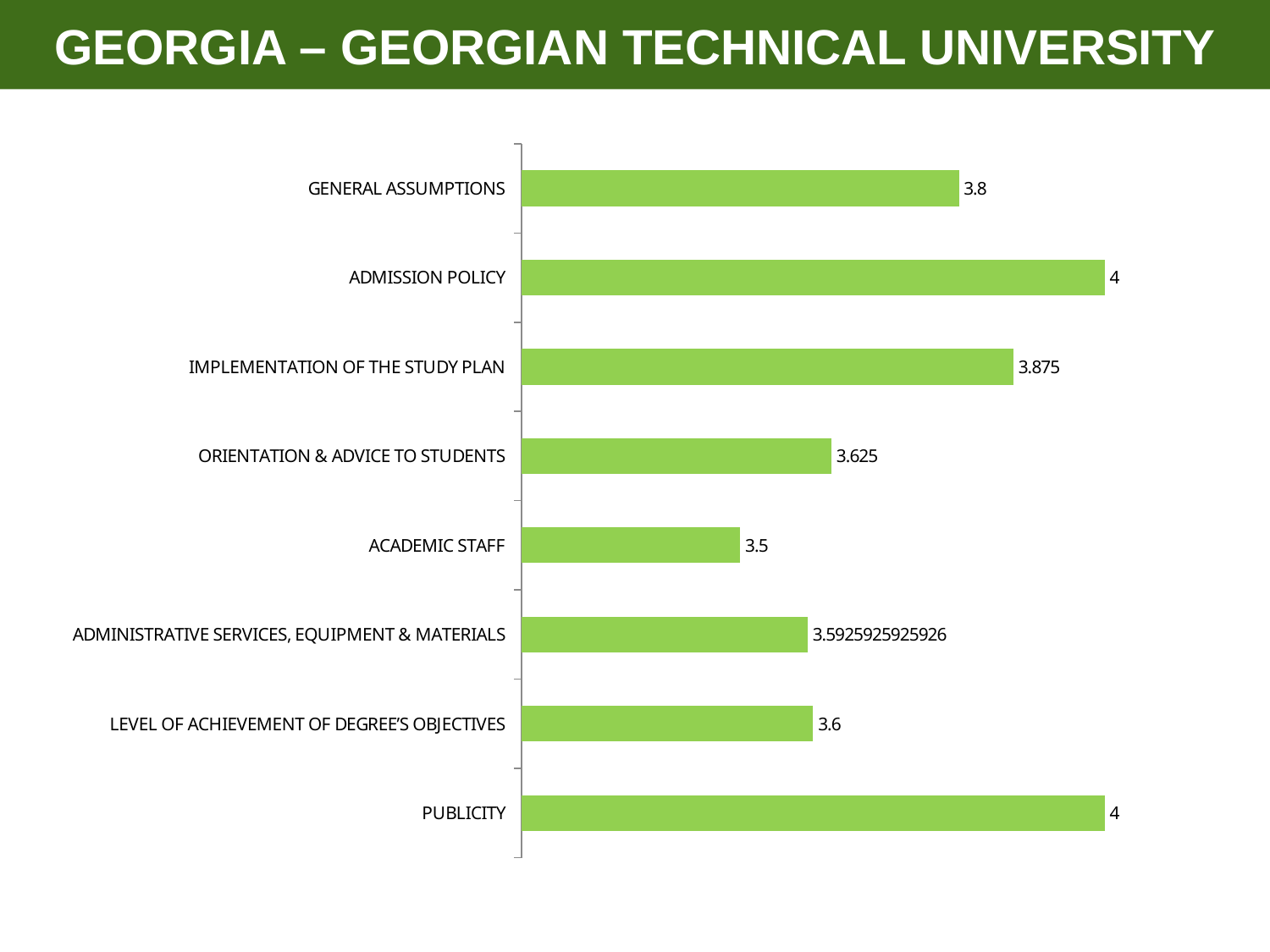
What is the value for IMPLEMENTATION OF THE STUDY PLAN? 3.875 What colour are the bars in the chart? Green Which is larger, the value for GENERAL ASSUMPTIONS or the value for ORIENTATION & ADVICE TO STUDENTS? GENERAL ASSUMPTIONS What is the value for ADMINISTRATIVE SERVICES, EQUIPMENT & MATERIALS? 3.5925925925926 What is the value for LEVEL OF ACHIEVEMENT OF DEGREE'S OBJECTIVES? 3.6 What is the difference between the values for ADMISSION POLICY and ACADEMIC STAFF? 0.5 What is the value for GENERAL ASSUMPTIONS? 3.8 How many categories are shown in the chart? 8 Which category has the lowest value? ACADEMIC STAFF What is the value for ORIENTATION & ADVICE TO STUDENTS? 3.625 What kind of chart is shown on the slide? Bar chart What is the difference between the values for IMPLEMENTATION OF THE STUDY PLAN and GENERAL ASSUMPTIONS? 0.075